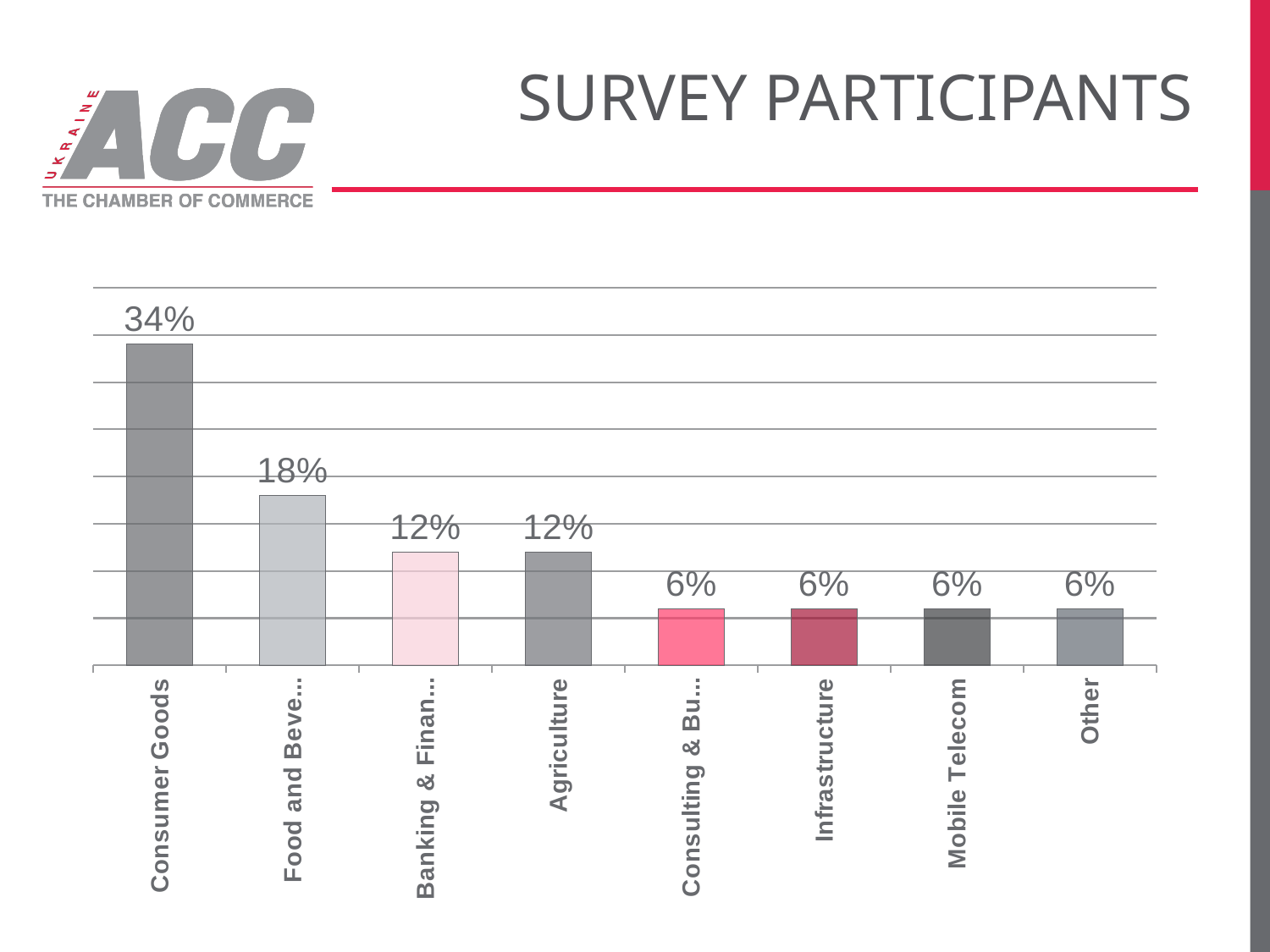
What type of chart is shown on the slide? Bar chart What is the value shown for Mobile Telecom? 6% How many categories are shown in the chart? 8 Which is larger, the value for Consumer Goods or the value for Agriculture? Consumer Goods What is the value shown for Other? 6% What percentage of survey participants are from Consumer Goods? 34% What is the value shown for Agriculture? 12% Which category has the highest share of survey participants? Consumer Goods Which is larger, the value for Agriculture or the value for Mobile Telecom? Agriculture What is the value shown for Infrastructure? 6% What is the difference between the values for Consumer Goods and Agriculture? 22% What is the difference between the values for Agriculture and Infrastructure? 6%